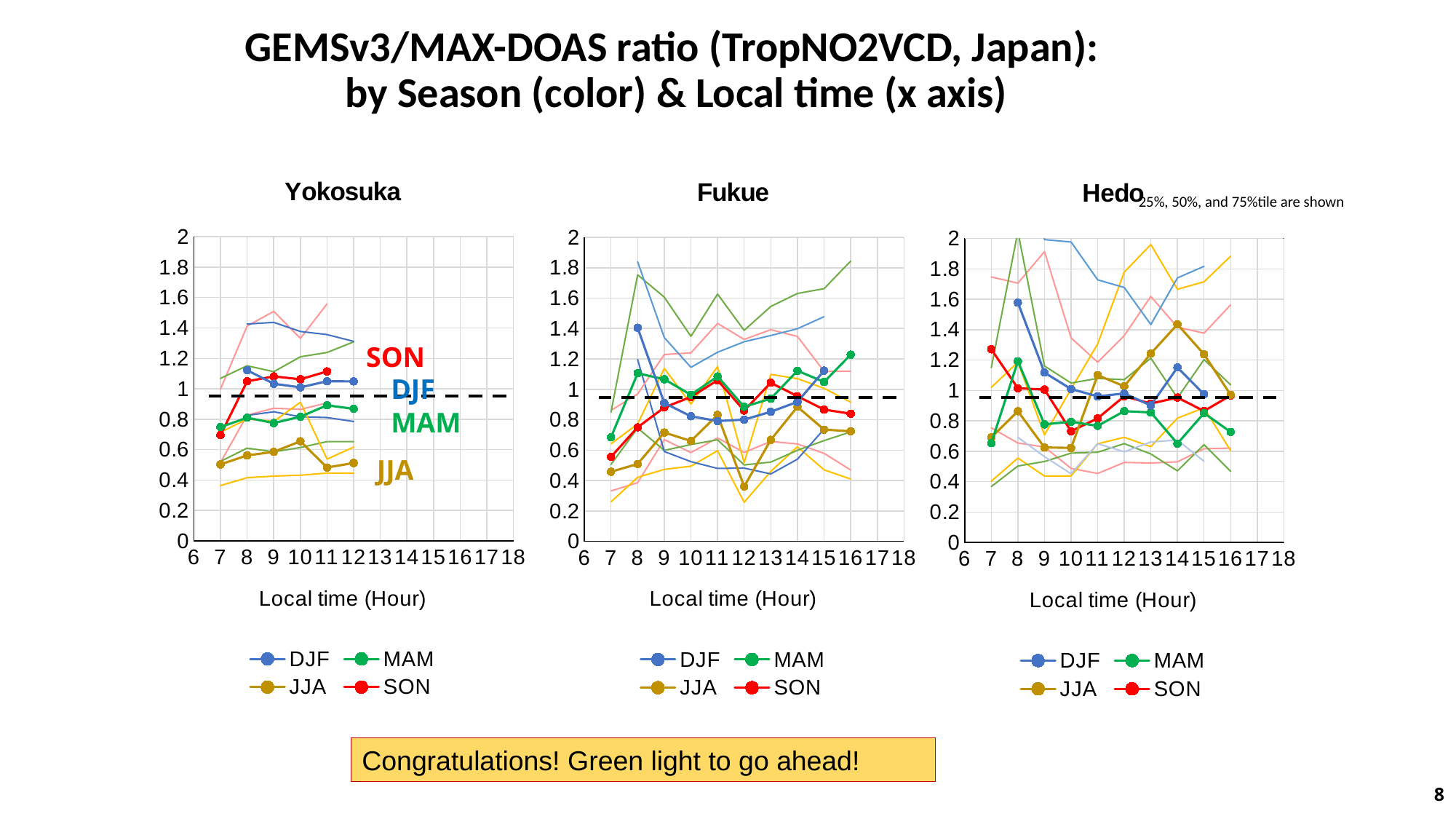
In the Yokosuka chart, is the JJA value at hour 11 greater or less than 0.6? less What is the x-axis label of the Yokosuka chart? Local time (Hour) In the Yokosuka chart, how many hourly points are plotted for the DJF series? 5 In the Fukue chart, is the JJA value at hour 12 greater or less than 0.6? less What are the legend entries of the Hedo chart? DJF, MAM, JJA, SON In the Fukue chart, is the DJF value at hour 8 greater or less than 1.2? greater In the Yokosuka chart, at hour 8, which is larger, DJF or JJA? DJF How many series does the legend of the Fukue chart list? 4 What kind of chart is the Yokosuka chart? line chart